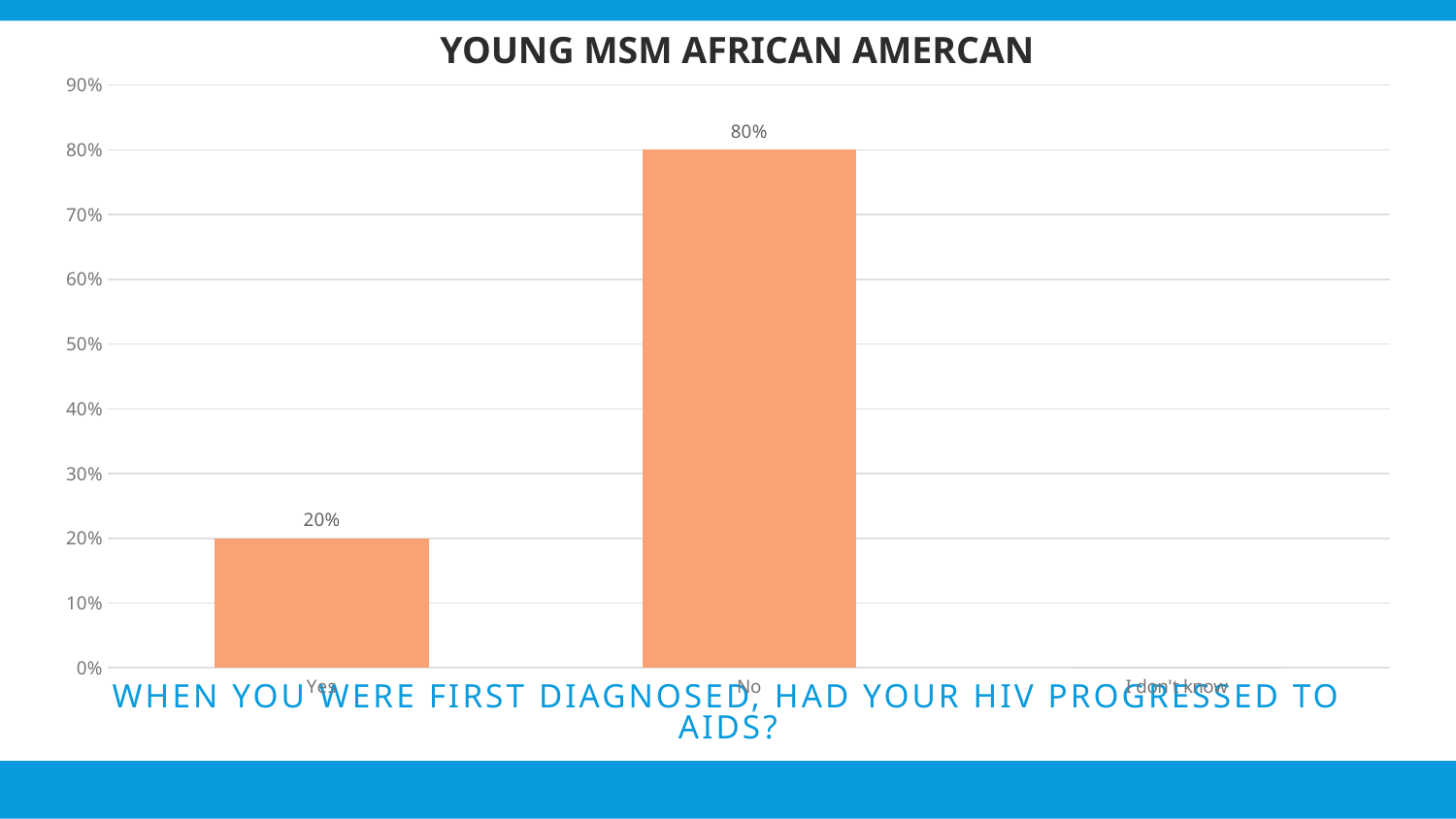
Is the value for "No" greater or less than 50%? greater Which category has the highest value? No How many bars are plotted on the chart? 2 Which is larger, the value for "Yes" or the value for "No"? No What is the value for the "Yes" category? 20% Is the value for "Yes" greater or less than 30%? less What is the title of the chart? YOUNG MSM AFRICAN AMERCAN What is the difference between the values for "No" and "Yes"? 60% What kind of chart is shown on the slide? bar chart What is the value for the "No" category? 80% What is the highest value shown on the vertical axis? 90%